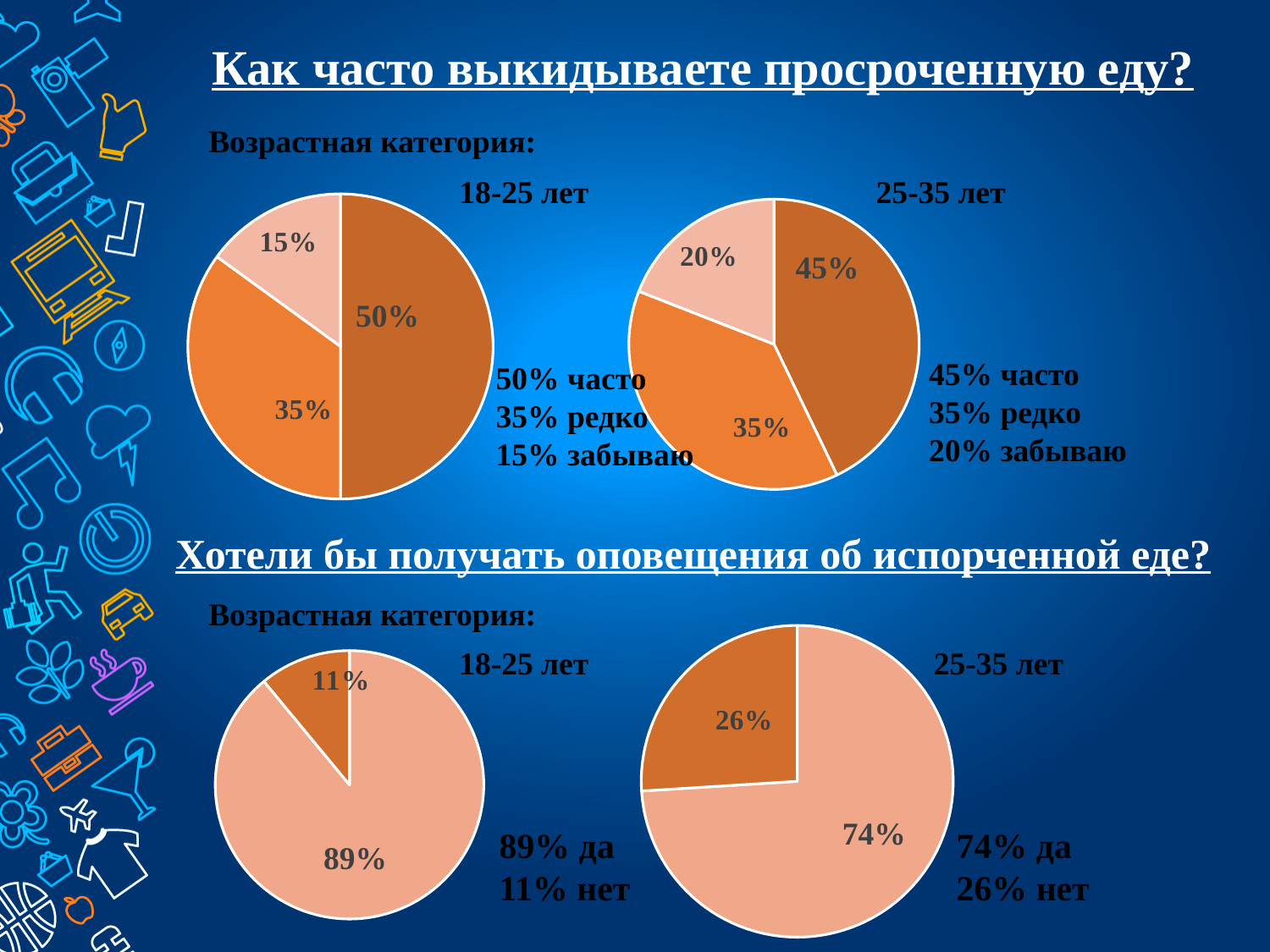
In the chart 'Как часто выкидываете просроченную еду?' for the 25-35 лет group, which answer has the largest slice? часто How many slices does the 25-35 лет pie in 'Как часто выкидываете просроченную еду?' have? 3 In the chart 'Как часто выкидываете просроченную еду?' for the 18-25 лет group, what is the difference between the 'часто' and 'редко' shares? 15% In the chart 'Хотели бы получать оповещения об испорченной еде?' for the 18-25 лет group, what share answered 'да'? 89% In the chart 'Хотели бы получать оповещения об испорченной еде?' for the 25-35 лет group, what is the difference between the 'да' and 'нет' shares? 48% How many pie charts are shown on the slide in total? 4 In the chart 'Хотели бы получать оповещения об испорченной еде?' for the 25-35 лет group, what share answered 'нет'? 26% In the chart 'Как часто выкидываете просроченную еду?' for the 18-25 лет group, what share of respondents answered 'часто'? 50% In the chart 'Как часто выкидываете просроченную еду?' for the 25-35 лет group, what share of respondents answered 'забываю'? 20% In the chart 'Как часто выкидываете просроченную еду?' for the 18-25 лет group, which answer has the smallest slice? забываю What type of chart is used for the 18-25 лет group in 'Хотели бы получать оповещения об испорченной еде?'? Pie chart Comparing the two pies in 'Как часто выкидываете просроченную еду?', which age group has the larger 'часто' share, 18-25 лет or 25-35 лет? 18-25 лет